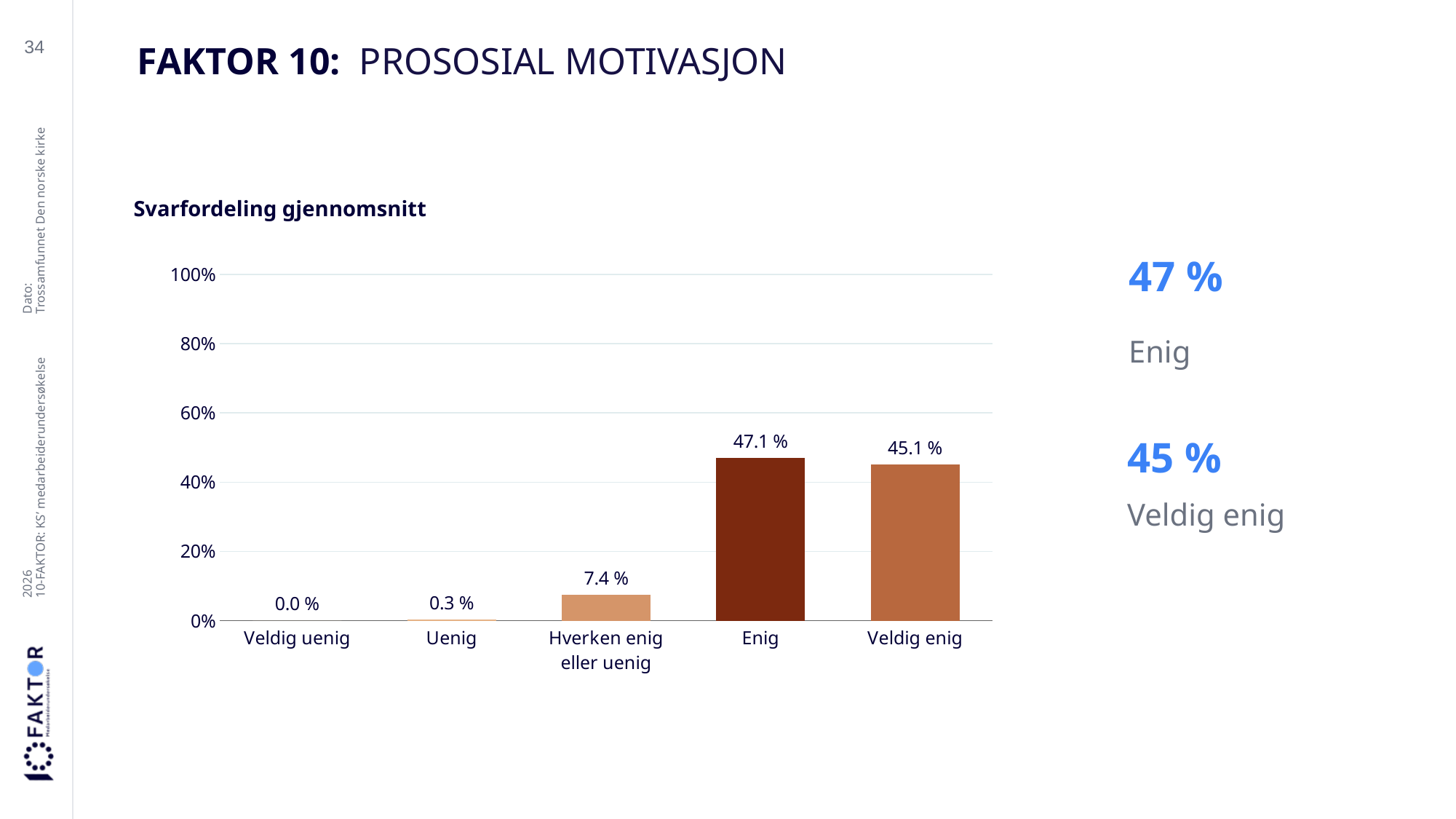
Which category has the lowest value? Veldig uenig What is the title of the chart? Svarfordeling gjennomsnitt What is the value for Veldig enig? 45.1 % What is the value for Enig? 47.1 % Is the value for Enig greater or less than 40%? greater What kind of chart is shown on the slide? bar chart How many categories are shown on the x axis? 5 Which category has the highest value? Enig Which is larger, the value for Hverken enig eller uenig or the value for Uenig? Hverken enig eller uenig What is the value for Uenig? 0.3 % What is the value for Hverken enig eller uenig? 7.4 % What is the difference between the values for Enig and Veldig enig? 2.0 %